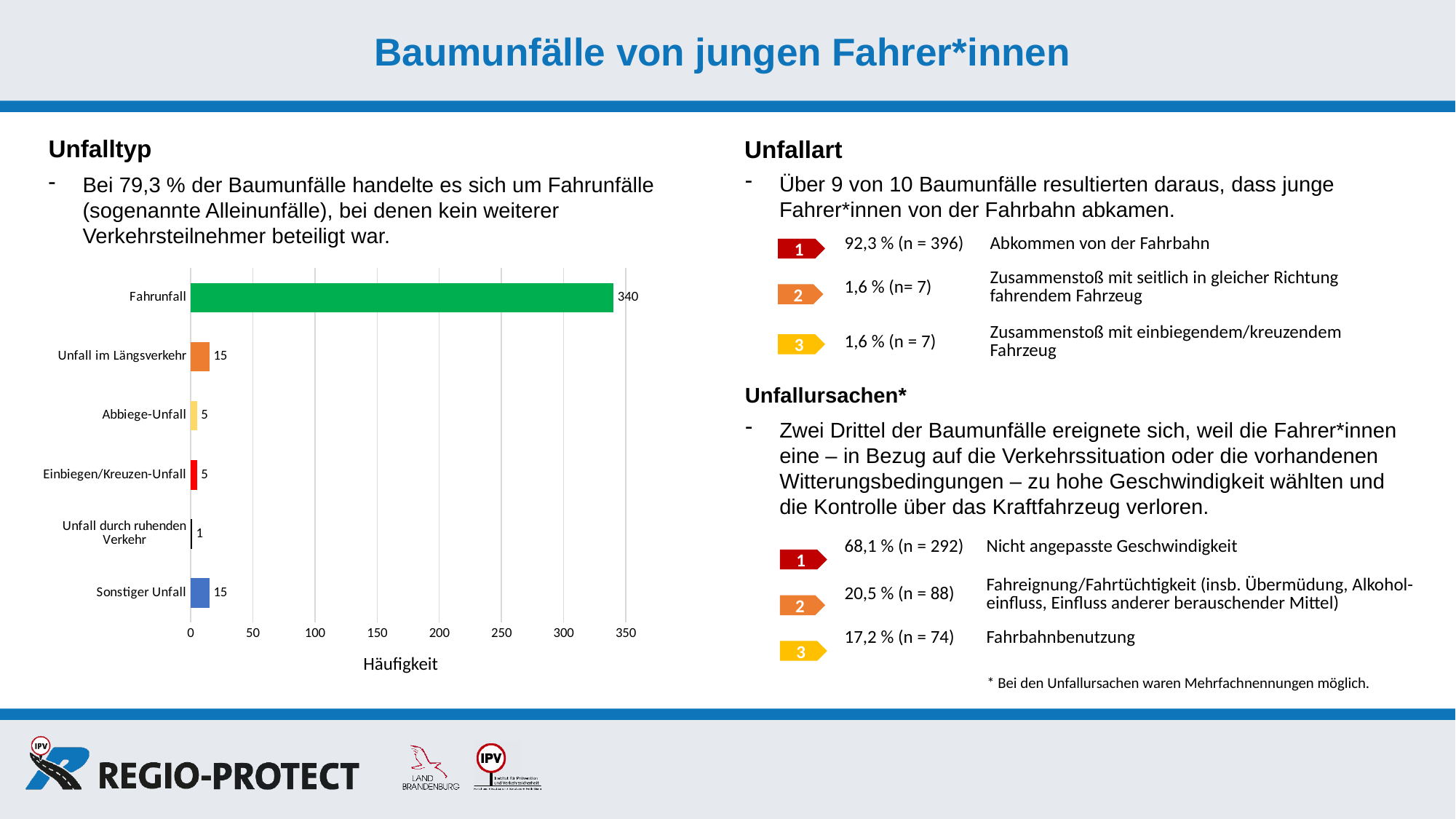
What is the difference between the values for Fahrunfall and Sonstiger Unfall in the bar chart? 325 What is the label of the horizontal axis of the bar chart? Häufigkeit How many categories are shown in the bar chart? 6 What kind of chart is shown on the slide? bar chart What is the value for Unfall durch ruhenden Verkehr in the bar chart? 1 Which category has the highest value in the bar chart? Fahrunfall What is the value for Unfall im Längsverkehr in the bar chart? 15 Which is larger in the bar chart: Unfall im Längsverkehr or Einbiegen/Kreuzen-Unfall? Unfall im Längsverkehr What is the value for Abbiege-Unfall in the bar chart? 5 What is the value for Fahrunfall in the bar chart? 340 Is the value for Fahrunfall in the bar chart greater or less than 300? greater Which category has the lowest value in the bar chart? Unfall durch ruhenden Verkehr